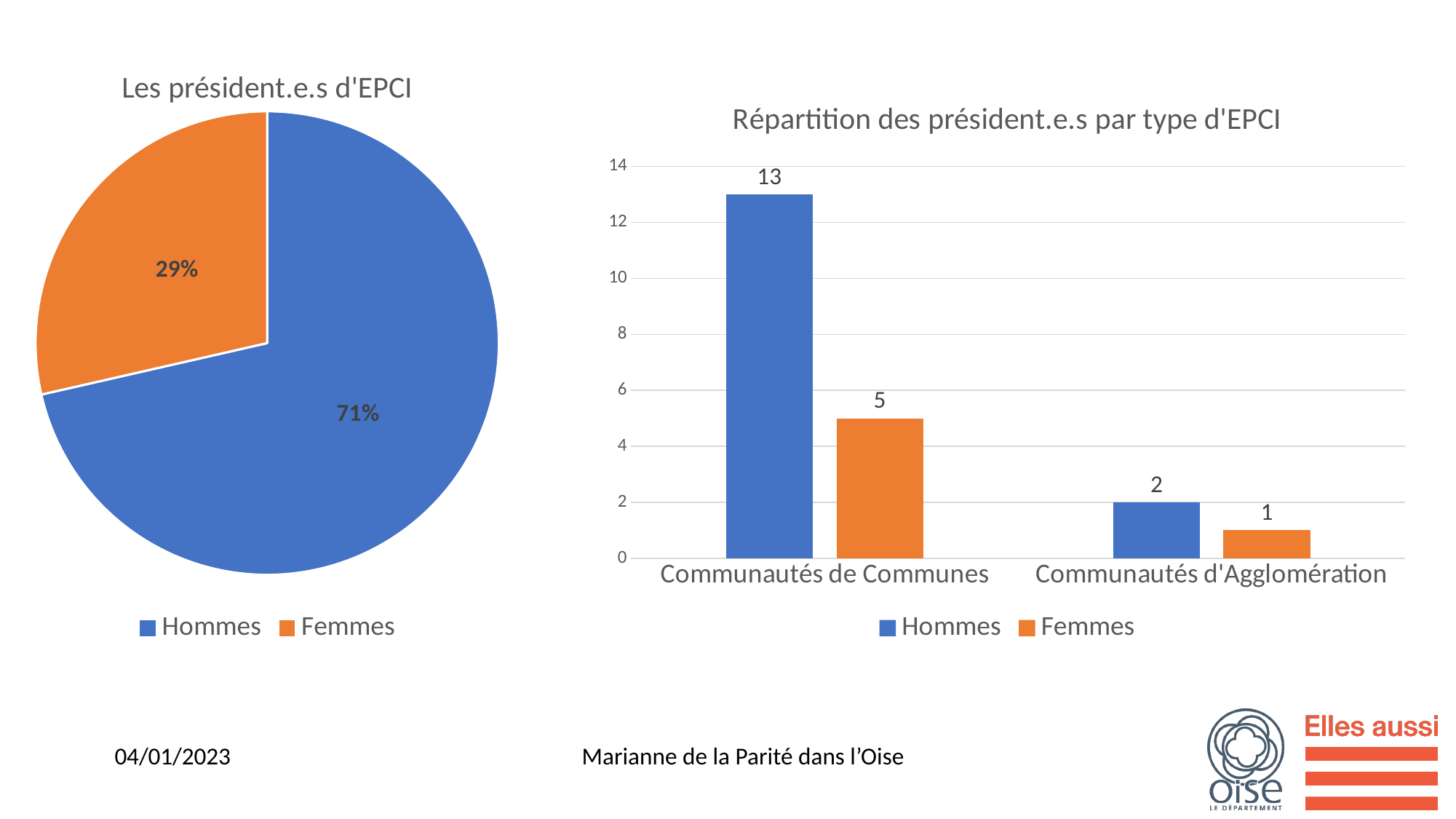
In the chart titled "Répartition des président.e.s par type d'EPCI", what is the difference between Hommes and Femmes in Communautés de Communes? 8 In the chart titled "Répartition des président.e.s par type d'EPCI", what is the value for Hommes in Communautés de Communes? 13 In the chart titled "Répartition des président.e.s par type d'EPCI", which bar is the highest? Hommes, Communautés de Communes In the chart titled "Les président.e.s d'EPCI", which slice is larger, Hommes or Femmes? Hommes In the chart titled "Répartition des président.e.s par type d'EPCI", how many categories are shown on the x axis? 2 In the chart titled "Répartition des président.e.s par type d'EPCI", which bar is the lowest? Femmes, Communautés d'Agglomération In the chart titled "Les président.e.s d'EPCI", what share of the pie is Femmes? 29% What kind of chart is "Les président.e.s d'EPCI"? Pie chart In the chart titled "Répartition des président.e.s par type d'EPCI", how many series does the legend list? 2 In the chart titled "Les président.e.s d'EPCI", what share of the pie is Hommes? 71% What kind of chart is "Répartition des président.e.s par type d'EPCI"? Bar chart In the chart titled "Répartition des président.e.s par type d'EPCI", what is the value for Femmes in Communautés d'Agglomération? 1